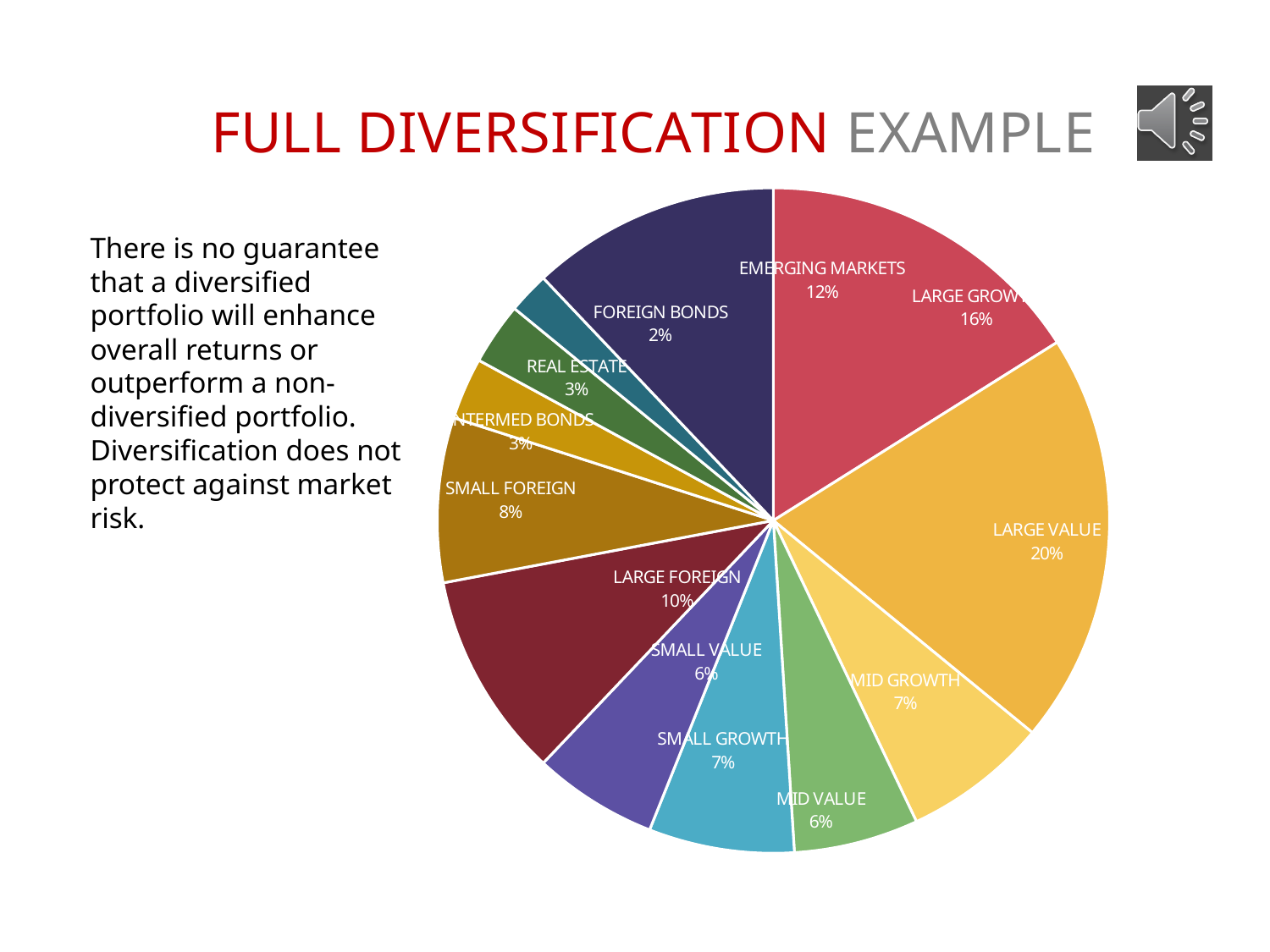
What percentage is shown for LARGE FOREIGN? 10% What kind of chart is shown on the slide? Pie chart Which slice of the pie is the smallest? FOREIGN BONDS What percentage is shown for REAL ESTATE? 3% Which slice of the pie is the largest? LARGE VALUE How many percentage points larger is LARGE VALUE than EMERGING MARKETS? 8 percentage points Which is larger, MID GROWTH or MID VALUE? MID GROWTH What percentage is shown for SMALL FOREIGN? 8% What share of the pie does LARGE VALUE represent? 20% How many slices does the pie chart have? 12 What is the combined share of SMALL GROWTH and SMALL VALUE? 13% What percentage is shown for EMERGING MARKETS? 12%